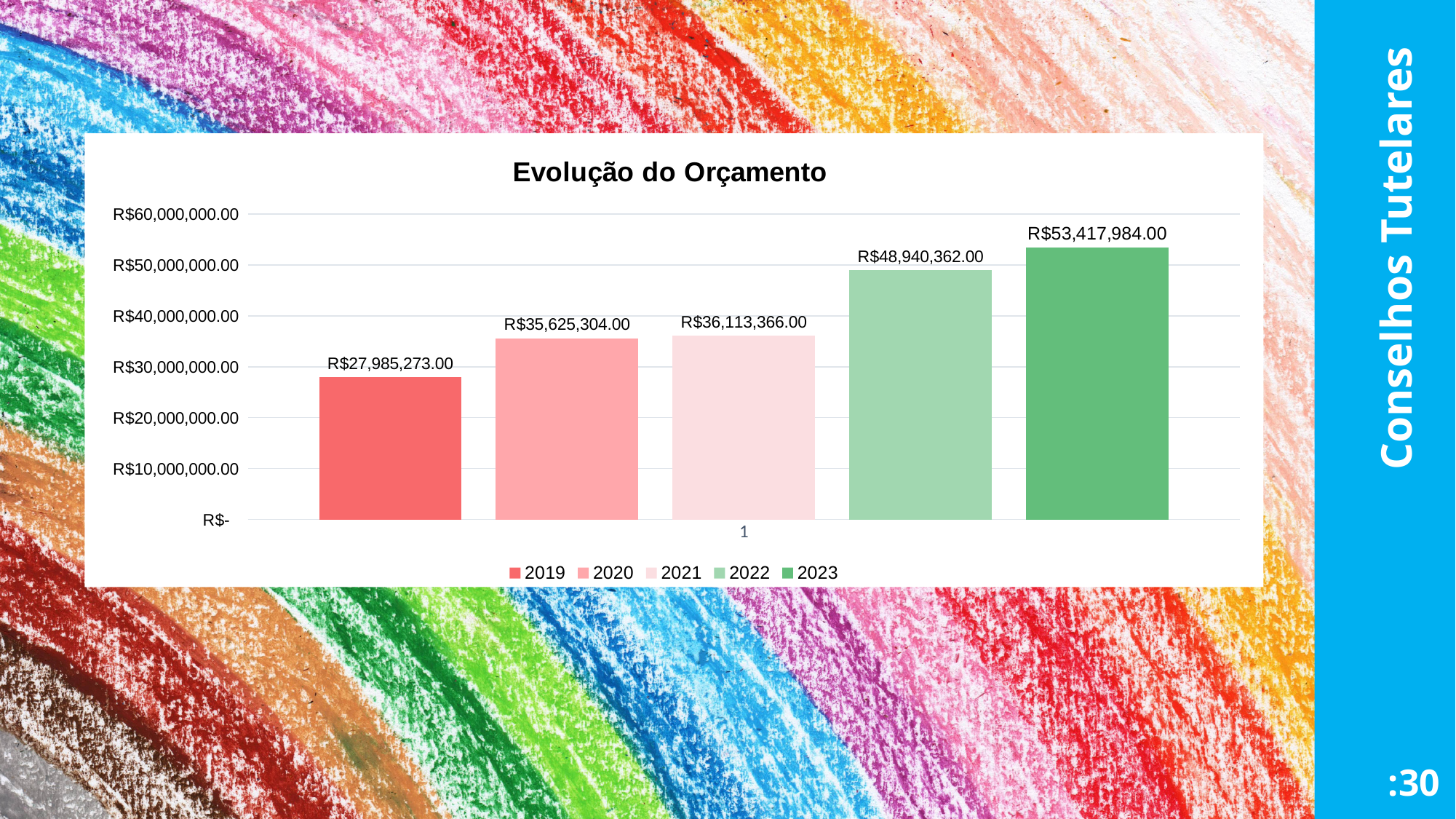
Which is larger in the Evolução do Orçamento chart, the value for 2020 or the value for 2021? 2021 What is the difference between the 2023 and 2022 values in the Evolução do Orçamento chart? R$4,477,622.00 Is the value for 2022 in the Evolução do Orçamento chart greater or less than R$40,000,000.00? greater What is the value for 2021 in the Evolução do Orçamento chart? R$36,113,366.00 What is the value for 2022 in the Evolução do Orçamento chart? R$48,940,362.00 What is the difference between the 2023 and 2019 values in the Evolução do Orçamento chart? R$25,432,711.00 What kind of chart is the Evolução do Orçamento chart? bar chart Do the values in the Evolução do Orçamento chart rise or fall from 2019 to 2023? rise What is the value for 2019 in the Evolução do Orçamento chart? R$27,985,273.00 How many series does the legend of the Evolução do Orçamento chart list? 5 Which year has the lowest value in the Evolução do Orçamento chart? 2019 Which year has the highest value in the Evolução do Orçamento chart? 2023